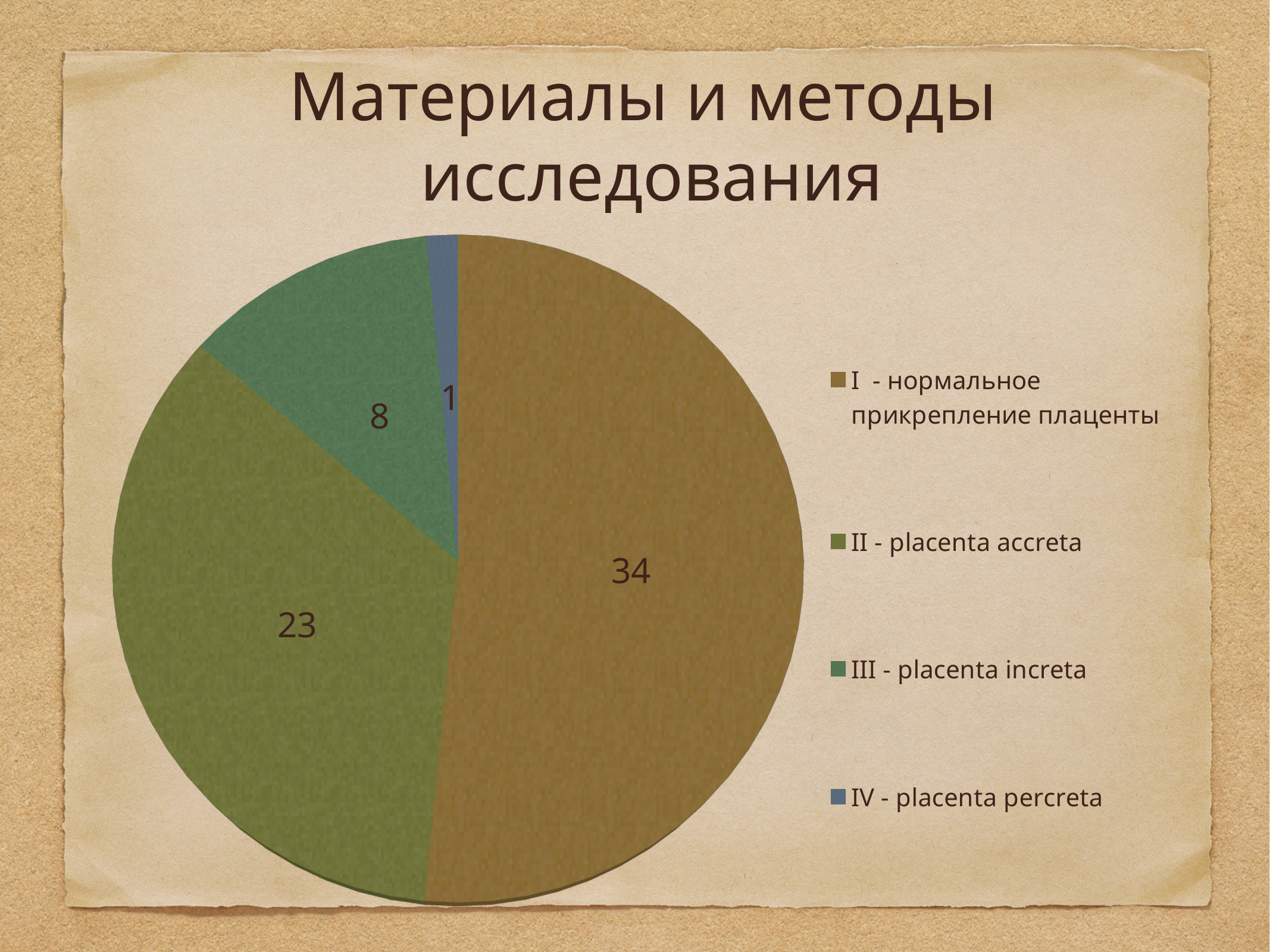
What is the value for 'IV - placenta percreta'? 1 What is the title of the slide containing the chart? Материалы и методы исследования Which category has the largest slice of the pie? I - нормальное прикрепление плаценты What is the value for 'III - placenta increta'? 8 What is the difference between the values for 'I - нормальное прикрепление плаценты' and 'II - placenta accreta'? 11 What is the total of all the slices in the pie chart? 66 Which is larger, the value for 'II - placenta accreta' or 'III - placenta increta'? II - placenta accreta How many slices does the pie chart have? 4 What type of chart is shown on the slide? pie chart What is the value for 'I - нормальное прикрепление плаценты'? 34 What is the value for 'II - placenta accreta'? 23 Which category has the smallest slice of the pie? IV - placenta percreta